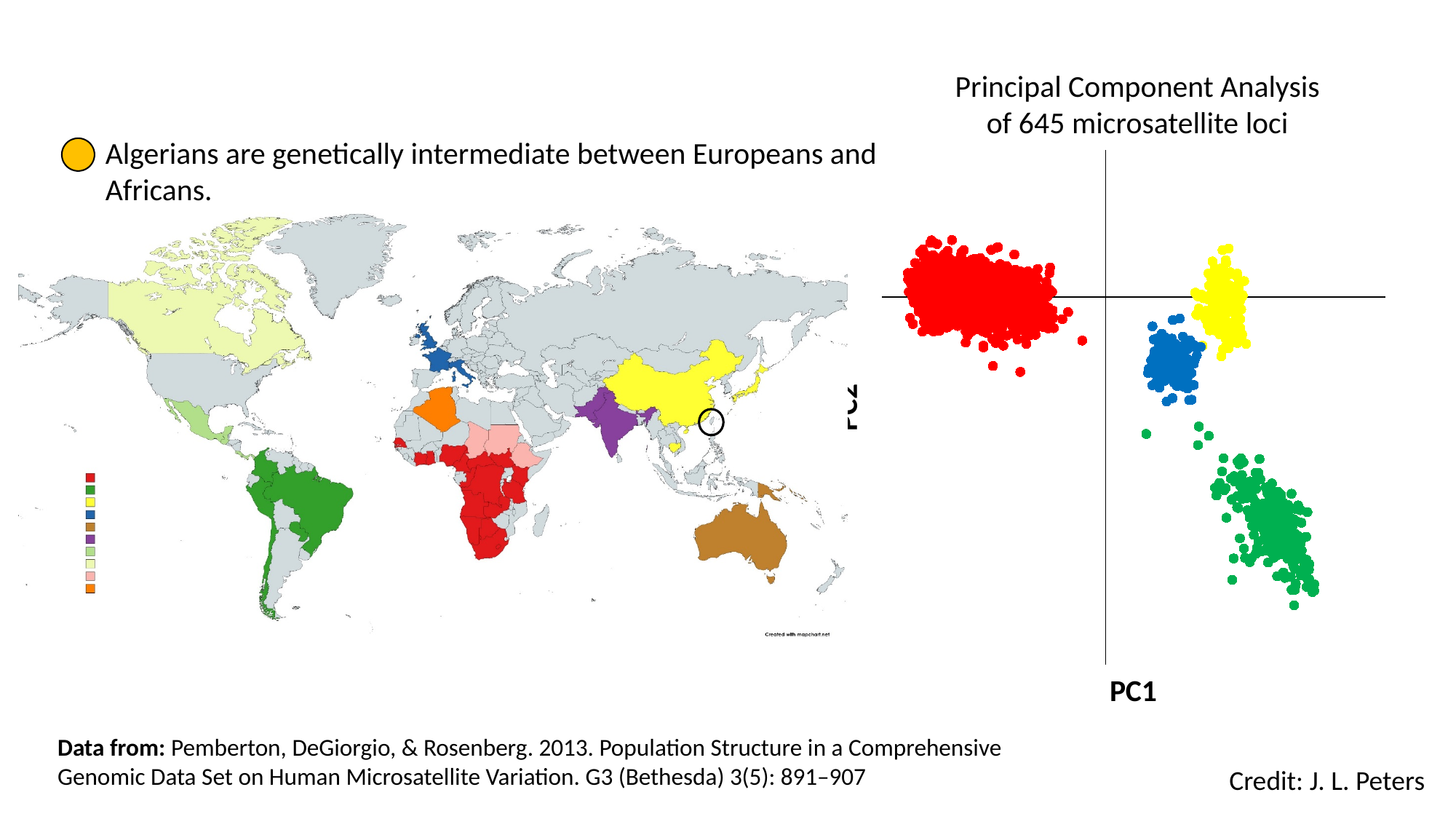
In the scatter plot, is the green cluster above or below the horizontal axis line? below In the scatter plot, is the red cluster to the left or to the right of the vertical axis line? left What kind of chart is the 'Principal Component Analysis of 645 microsatellite loci' chart? scatter plot In the scatter plot, which cluster lies further to the right along PC1, the green cluster or the blue cluster? green How many distinct coloured clusters of points are shown in the scatter plot? 4 What is the title of the scatter plot on the right of the slide? Principal Component Analysis of 645 microsatellite loci In the scatter plot, which coloured cluster extends lowest on the vertical axis? green What is the label of the horizontal axis of the scatter plot? PC1 In the scatter plot, which coloured cluster lies furthest to the left along PC1? red